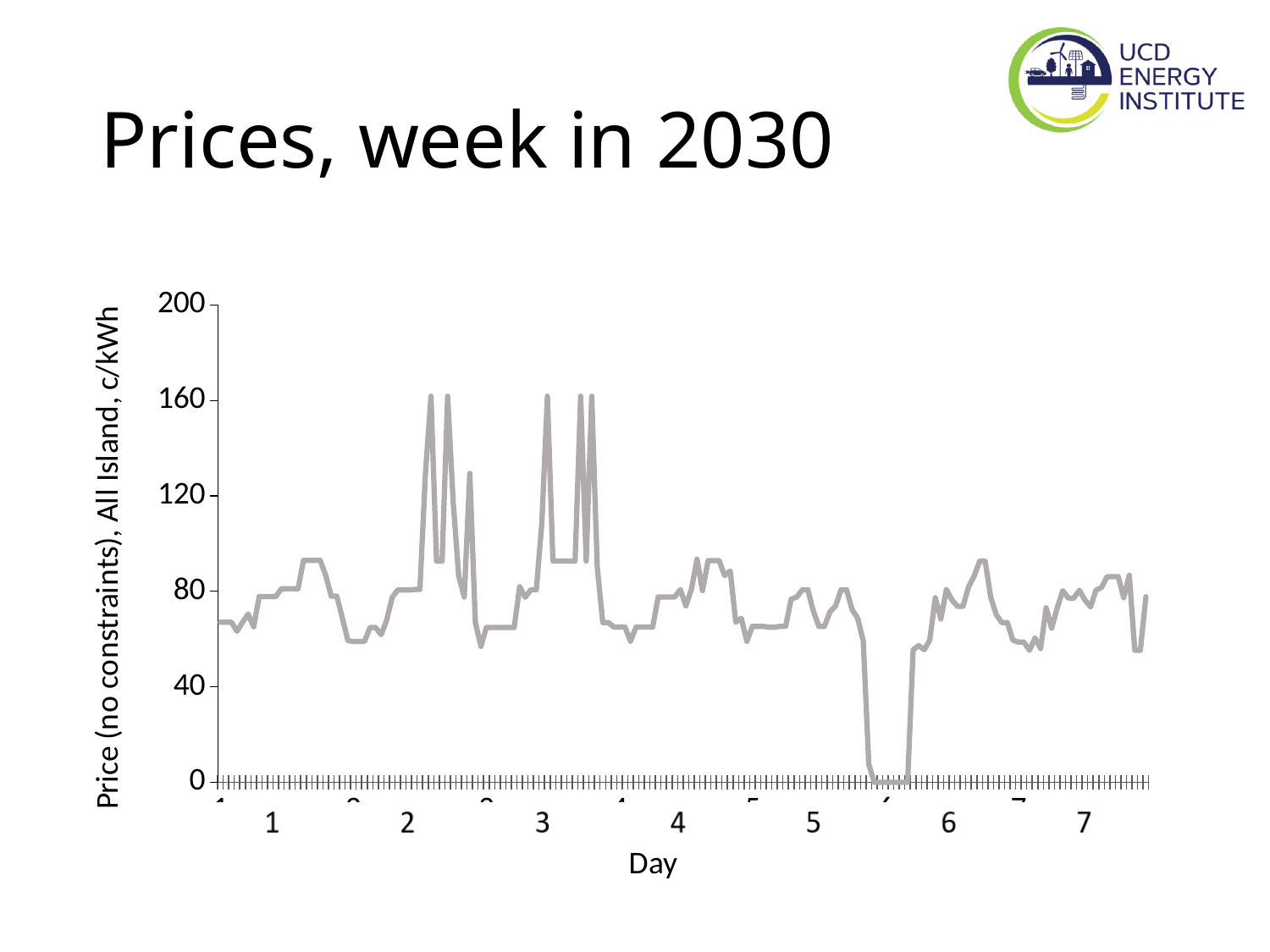
What is the title of the chart on the slide? Prices, week in 2030 Is the highest price spike on day 2 greater or less than 120 c/kWh? greater What kind of chart is shown on the slide? line chart Which day shows the price dropping to the bottom of the axis, day 1 or the period between day 5 and day 6? between day 5 and day 6 Is the highest price reached on day 1 greater or less than 120 c/kWh? less Is the highest price reached on day 7 greater or less than 120 c/kWh? less How many days are labelled along the x axis of the chart? 7 What is the label of the vertical axis of the chart? Price (no constraints), All Island, c/kWh What is the maximum value shown on the vertical axis of the chart? 200